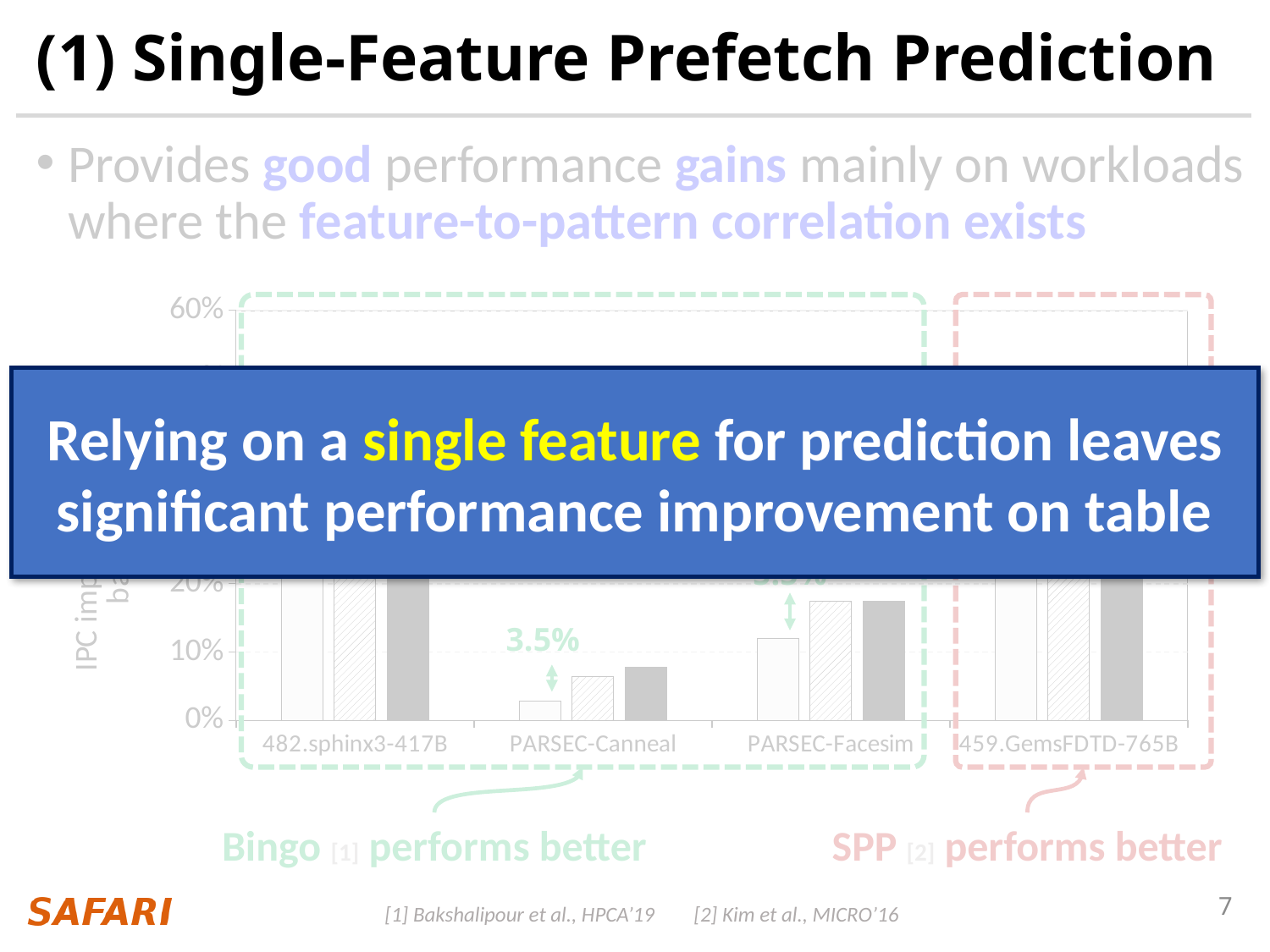
What percentage value is annotated above the PARSEC-Canneal bars? 3.5% How many workload categories are shown on the x axis of the chart? 4 Are the bars for PARSEC-Canneal greater or less than 10%? less Within PARSEC-Canneal, which is taller, the gray bar or the white bar? the gray bar Are the bars for 482.sphinx3-417B greater or less than 20%? greater Which has taller bars, PARSEC-Facesim or PARSEC-Canneal? PARSEC-Facesim Is the gray bar for PARSEC-Facesim greater or less than 20%? less How many bars are plotted for each workload category in the chart? 3 What kind of chart is shown on the slide? bar chart Which workload category has the lowest bars in the chart? PARSEC-Canneal What is the highest tick value shown on the y axis of the chart? 60% Which workload category is enclosed in the red dashed box labelled 'SPP performs better'? 459.GemsFDTD-765B